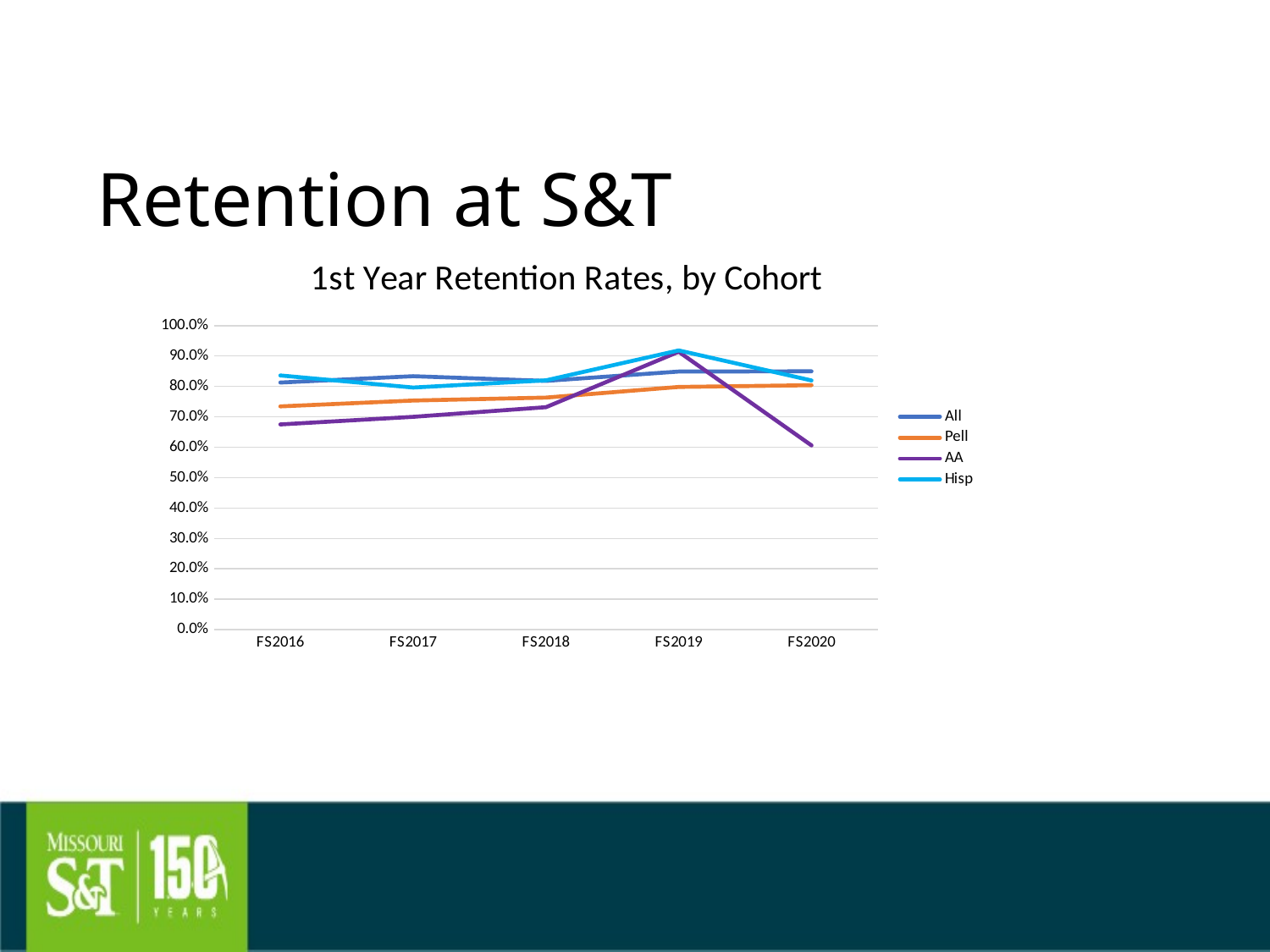
Does the Pell series rise or fall from FS2016 to FS2019? rise Is the value for AA in FS2019 greater or less than 80.0%? greater Is the value for AA in FS2020 greater or less than 70.0%? less For the AA series, which cohort has the highest retention rate? FS2019 Is the value for Hisp in FS2016 greater or less than 80.0%? greater In FS2020, which series has the larger value, Pell or AA? Pell What kind of chart is shown on the slide? line chart How many series does the legend list? 4 For the AA series, which cohort has the lowest retention rate? FS2020 How many cohorts are shown along the x axis? 5 In FS2016, which series has the larger value, All or AA? All